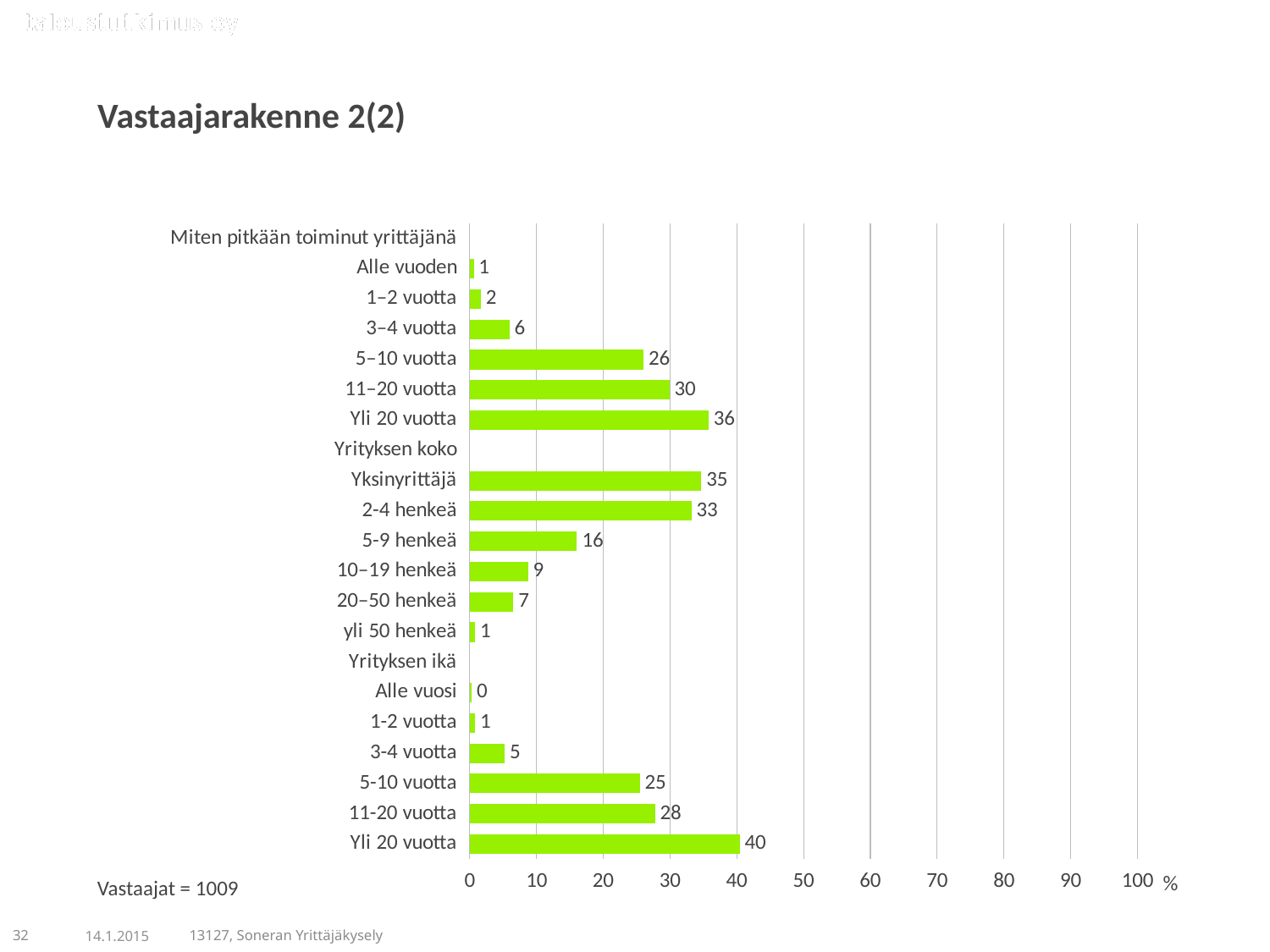
What type of chart is shown on the slide? bar chart Which category under "Yrityksen koko" has the lowest value? yli 50 henkeä Which category under "Yrityksen ikä" has the highest value? Yli 20 vuotta Under "Yrityksen ikä", what is the value for "11-20 vuotta"? 28 Under "Yrityksen koko", what is the value for "Yksinyrittäjä"? 35 What is the difference between "Yksinyrittäjä" and "2-4 henkeä" under "Yrityksen koko"? 2 Which bar is the longest in the whole chart? Yli 20 vuotta (Yrityksen ikä) How many categories are listed under "Yrityksen koko"? 6 What is the number of respondents (Vastaajat) stated on the slide? 1009 Under "Miten pitkään toiminut yrittäjänä", what is the value for "5–10 vuotta"? 26 What is the difference between "5-9 henkeä" and "10–19 henkeä" under "Yrityksen koko"? 7 Under "Miten pitkään toiminut yrittäjänä", which is larger: "11–20 vuotta" or "Yli 20 vuotta"? Yli 20 vuotta